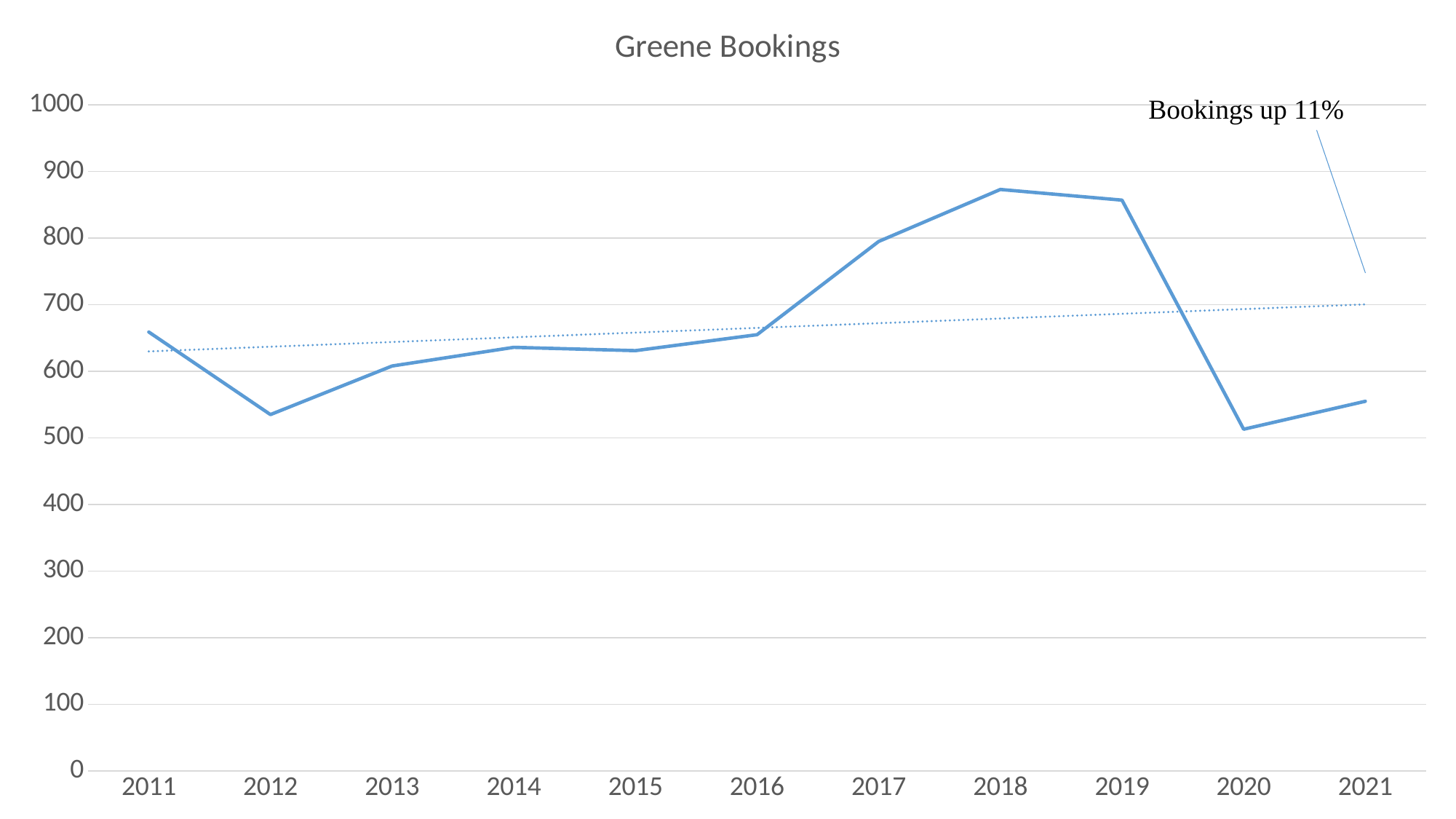
What does the text annotation on the chart say? Bookings up 11% Which year has the highest number of bookings? 2018 Is the value for 2020 greater or less than 600? less Do bookings rise or fall from 2019 to 2020? fall Is the value for 2011 greater or less than 600? greater What kind of chart is shown on the slide? line chart Which year has more bookings, 2016 or 2017? 2017 Which year has the lowest number of bookings? 2020 Is the value for 2012 greater or less than 600? less What is the title of the chart? Greene Bookings How many years are plotted along the x axis? 11